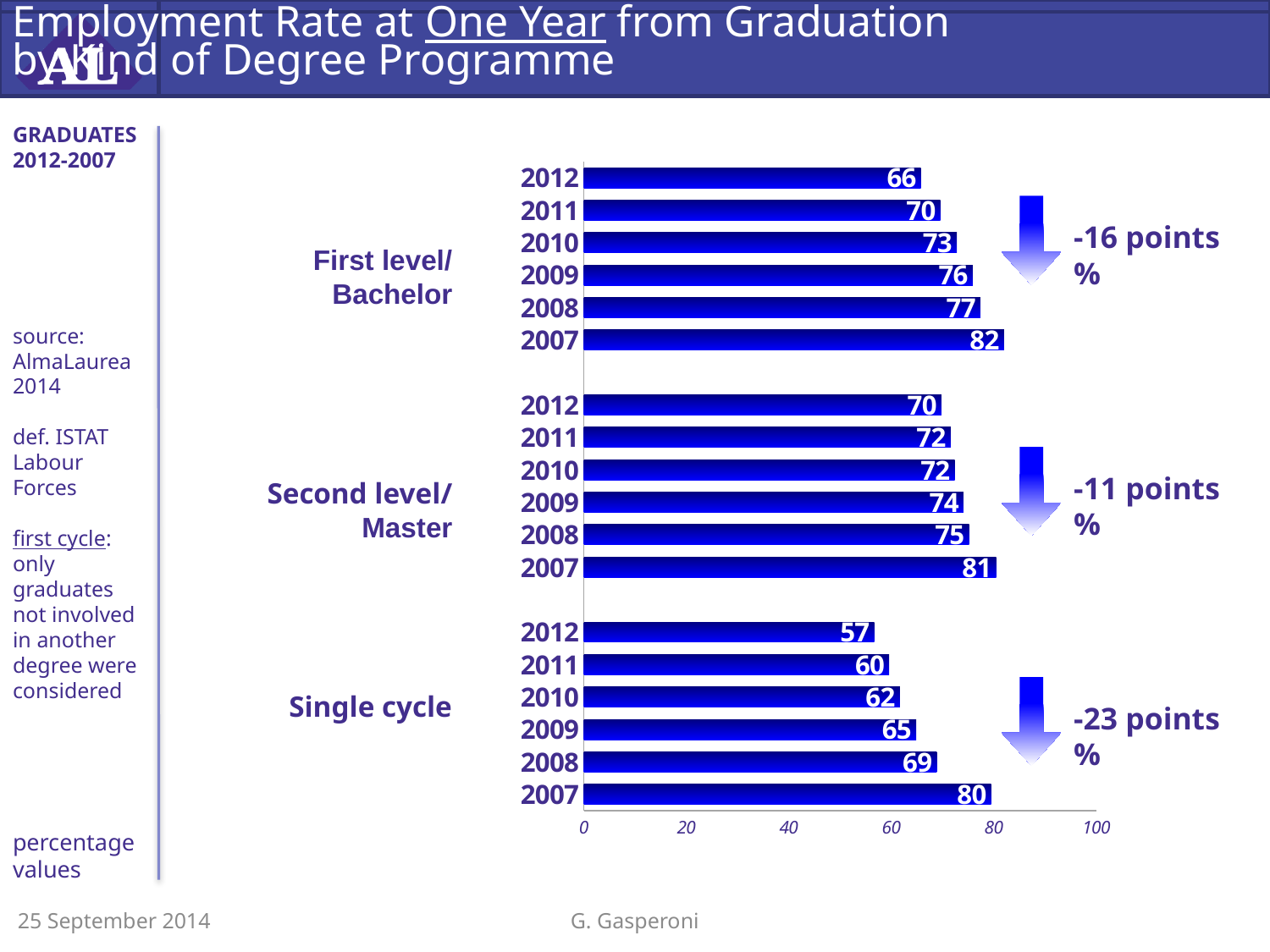
What is the employment rate for Second level/Master graduates in 2007? 81 How many years are shown for each kind of degree programme? 6 Which is larger: the 2012 employment rate for Second level/Master or for Single cycle? Second level/Master What is the employment rate for First level/Bachelor graduates in 2012? 66 Do the employment rates for Second level/Master graduates rise or fall from 2007 to 2012? fall What is the employment rate for Single cycle graduates in 2009? 65 Is the 2007 employment rate for First level/Bachelor graduates greater or less than 80? greater Which year has the lowest employment rate for First level/Bachelor graduates? 2012 What is the difference between the 2008 and 2012 employment rates for First level/Bachelor graduates? 11 What kind of chart is shown on the slide? bar chart Which year has the highest employment rate for Single cycle graduates? 2007 What is the difference between the 2007 and 2012 employment rates for Single cycle graduates? 23